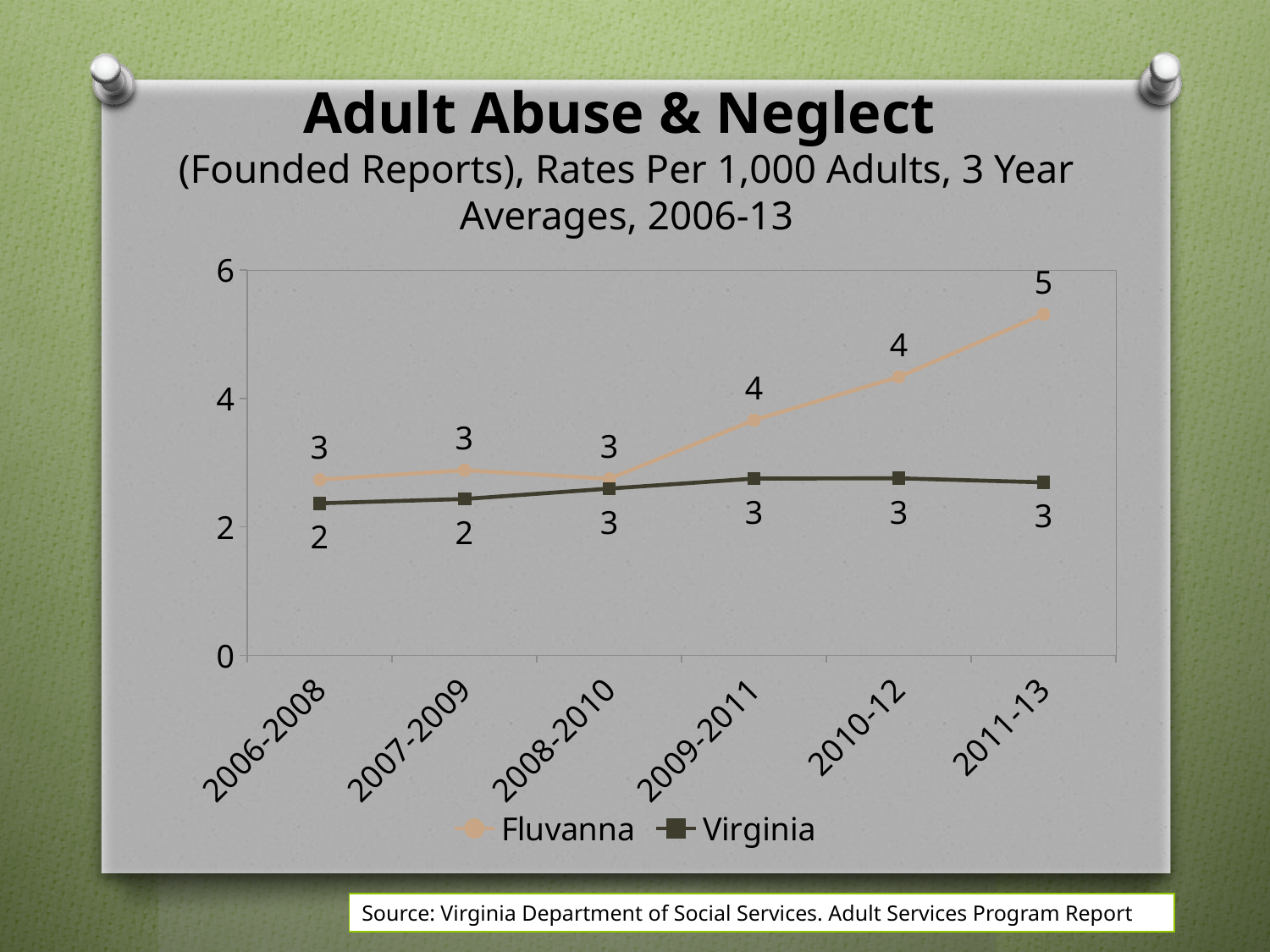
What kind of chart is shown on the slide? line chart How many time periods are shown on the x axis? 6 What is the Fluvanna value for 2009-2011? 4 In which period is the Fluvanna rate highest? 2011-13 What is the difference between the Fluvanna and Virginia values in 2011-13? 2 Does the Fluvanna line rise or fall from 2008-2010 to 2011-13? rise Is the Fluvanna value for 2011-13 greater or less than 4? greater What is the Virginia value for 2006-2008? 2 What is the Fluvanna value for 2011-13? 5 How many series does the legend list? 2 In 2011-13, which series has the larger value, Fluvanna or Virginia? Fluvanna Is the Virginia value for 2009-2011 greater or less than 4? less